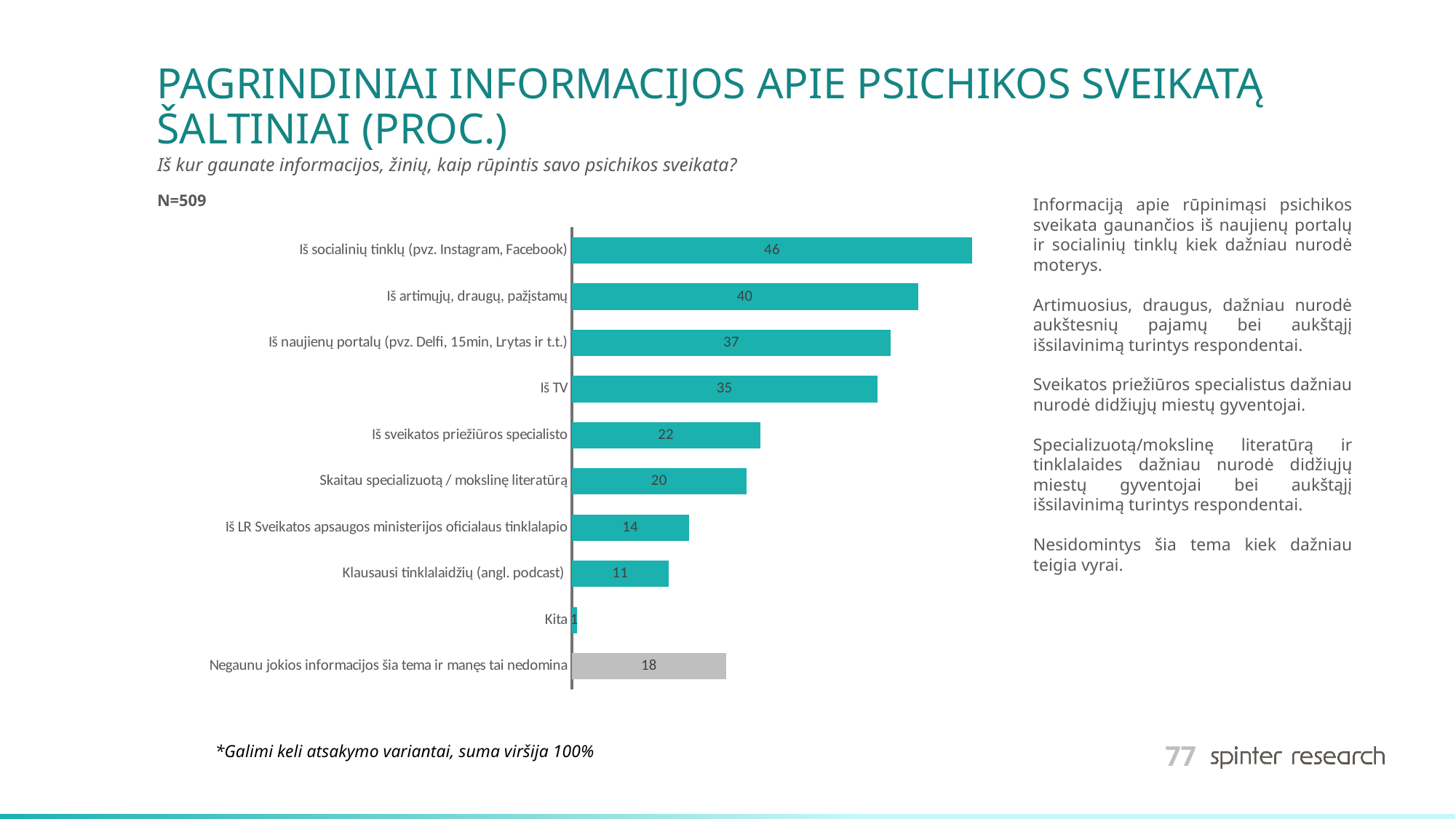
What is the sample size (N) stated on the slide? N=509 What is the value for "Iš TV"? 35 Which bar is coloured grey instead of teal? Negaunu jokios informacijos šia tema ir manęs tai nedomina Which is larger: the value for "Iš sveikatos priežiūros specialisto" or for "Skaitau specializuotą / mokslinę literatūrą"? Iš sveikatos priežiūros specialisto Which category has the lowest value? Kita How many categories are shown in the chart? 10 What kind of chart is shown on the slide? Bar chart What is the difference between the values for "Iš artimųjų, draugų, pažįstamų" and "Iš naujienų portalų (pvz. Delfi, 15min, Lrytas ir t.t.)"? 3 What is the value for "Negaunu jokios informacijos šia tema ir manęs tai nedomina"? 18 Which category has the highest value? Iš socialinių tinklų (pvz. Instagram, Facebook) What is the value for "Klausausi tinklalaidžių (angl. podcast)"? 11 What is the value for "Iš socialinių tinklų (pvz. Instagram, Facebook)"? 46